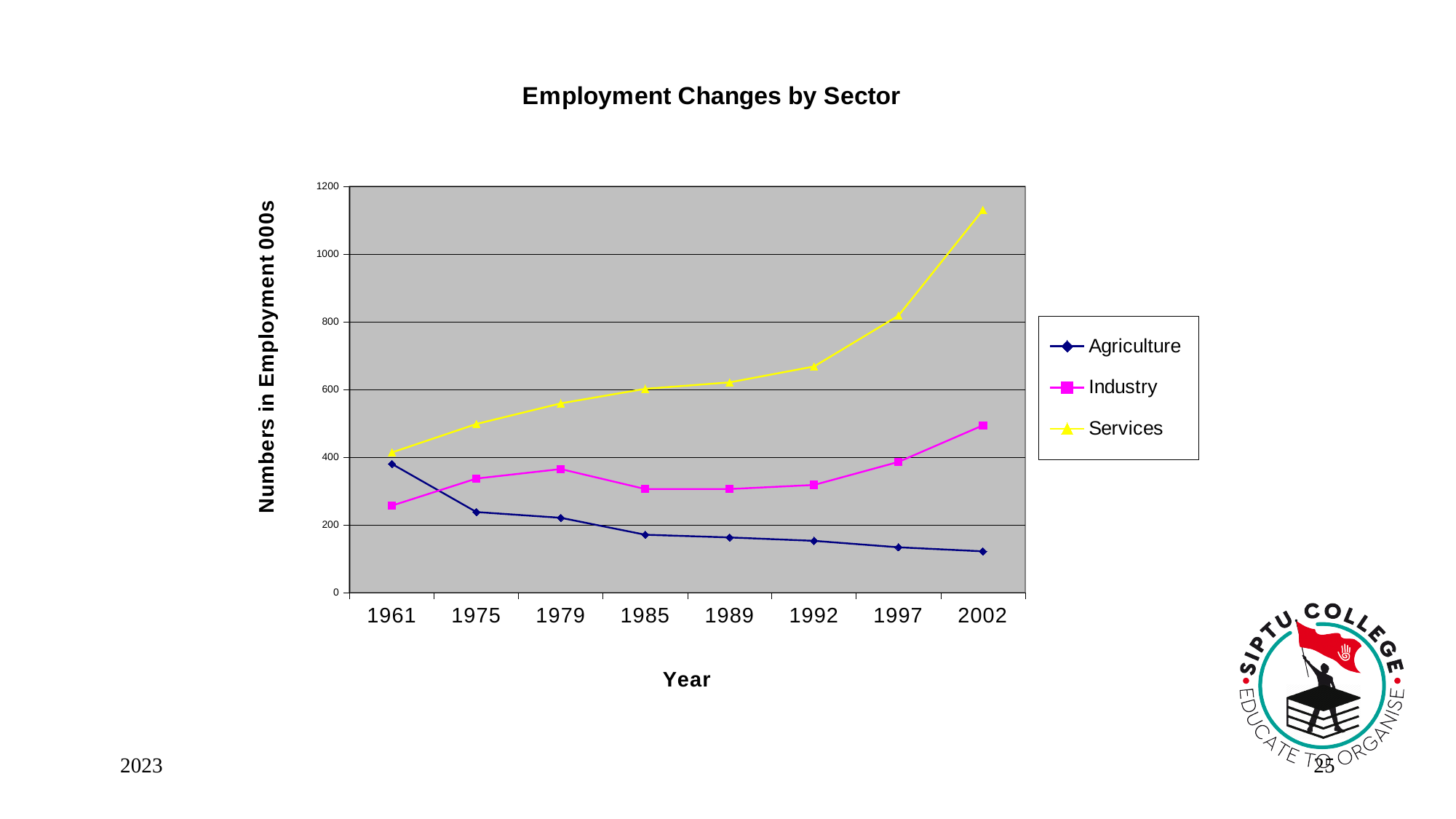
What is the title of the chart? Employment Changes by Sector Is the value for Services in 1961 greater or less than 600? less In which year is the Agriculture value lowest? 2002 Is the value for Agriculture in 2002 greater or less than 200? less Does the Agriculture line rise or fall from 1961 to 2002? Fall Is the value for Services in 2002 greater or less than 1000? greater What kind of chart is shown on the slide? Line chart What is the label on the vertical axis? Numbers in Employment 000s How many series does the legend list? 3 How many years are shown on the x axis? 8 Which sector has the highest value in 2002? Services